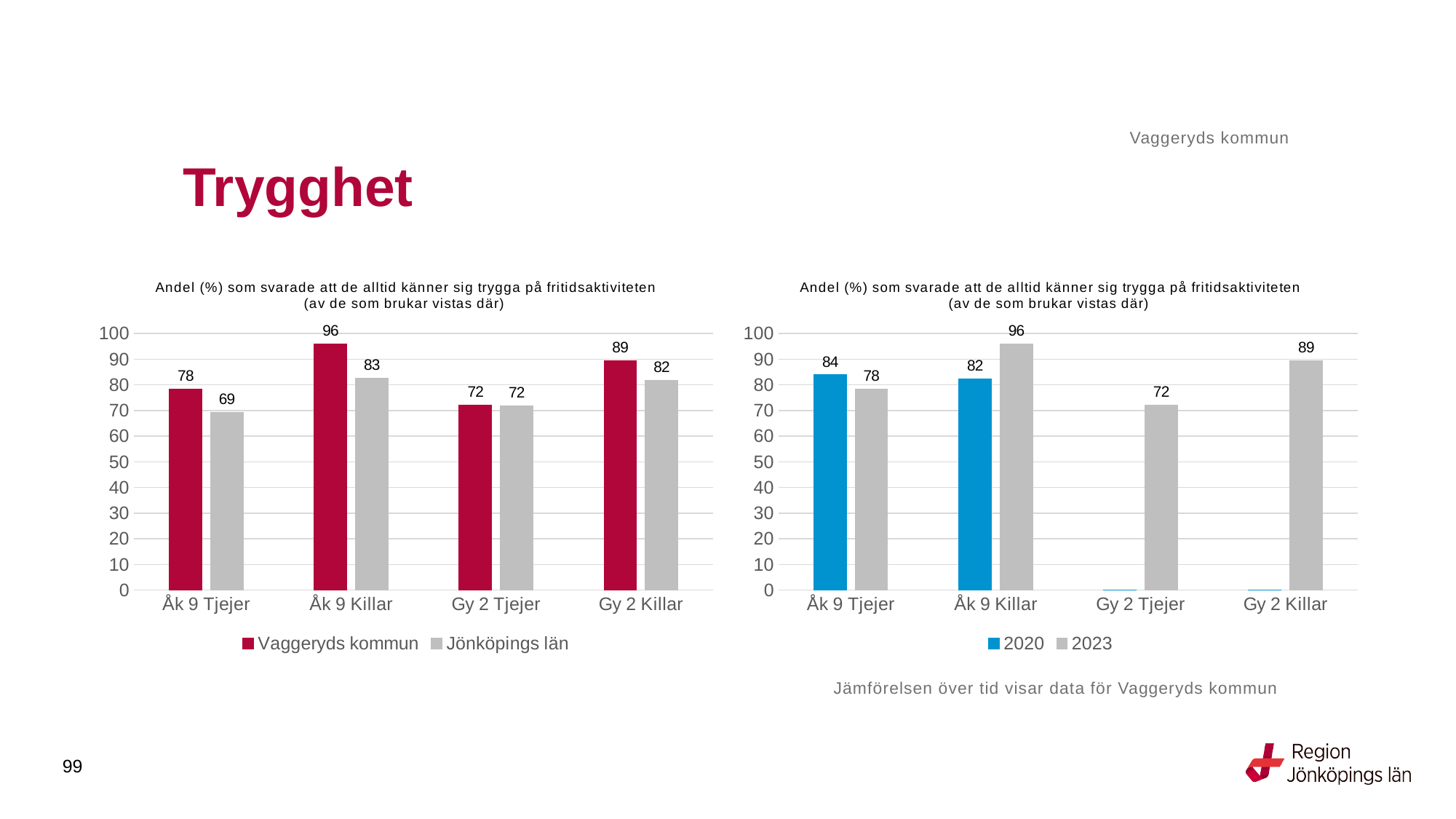
In the left chart, which category has the lowest value for Jönköpings län? Åk 9 Tjejer In the left chart, what is the value for Vaggeryds kommun for Åk 9 Killar? 96 In the left chart, which category has the highest value for Vaggeryds kommun? Åk 9 Killar In the left chart, which is larger for Gy 2 Killar: Vaggeryds kommun or Jönköpings län? Vaggeryds kommun In the right chart, which is larger for Åk 9 Tjejer: 2020 or 2023? 2020 In the left chart, what is the difference between Vaggeryds kommun and Jönköpings län for Åk 9 Killar? 13 What kind of chart is the left chart? Bar chart In the right chart, what is the value for 2020 for Åk 9 Tjejer? 84 In the right chart, what is the difference between 2023 and 2020 for Åk 9 Killar? 14 How many series does the legend of the right chart list? 2 In the left chart, what is the value for Jönköpings län for Åk 9 Tjejer? 69 In the right chart, what is the value for 2023 for Gy 2 Killar? 89